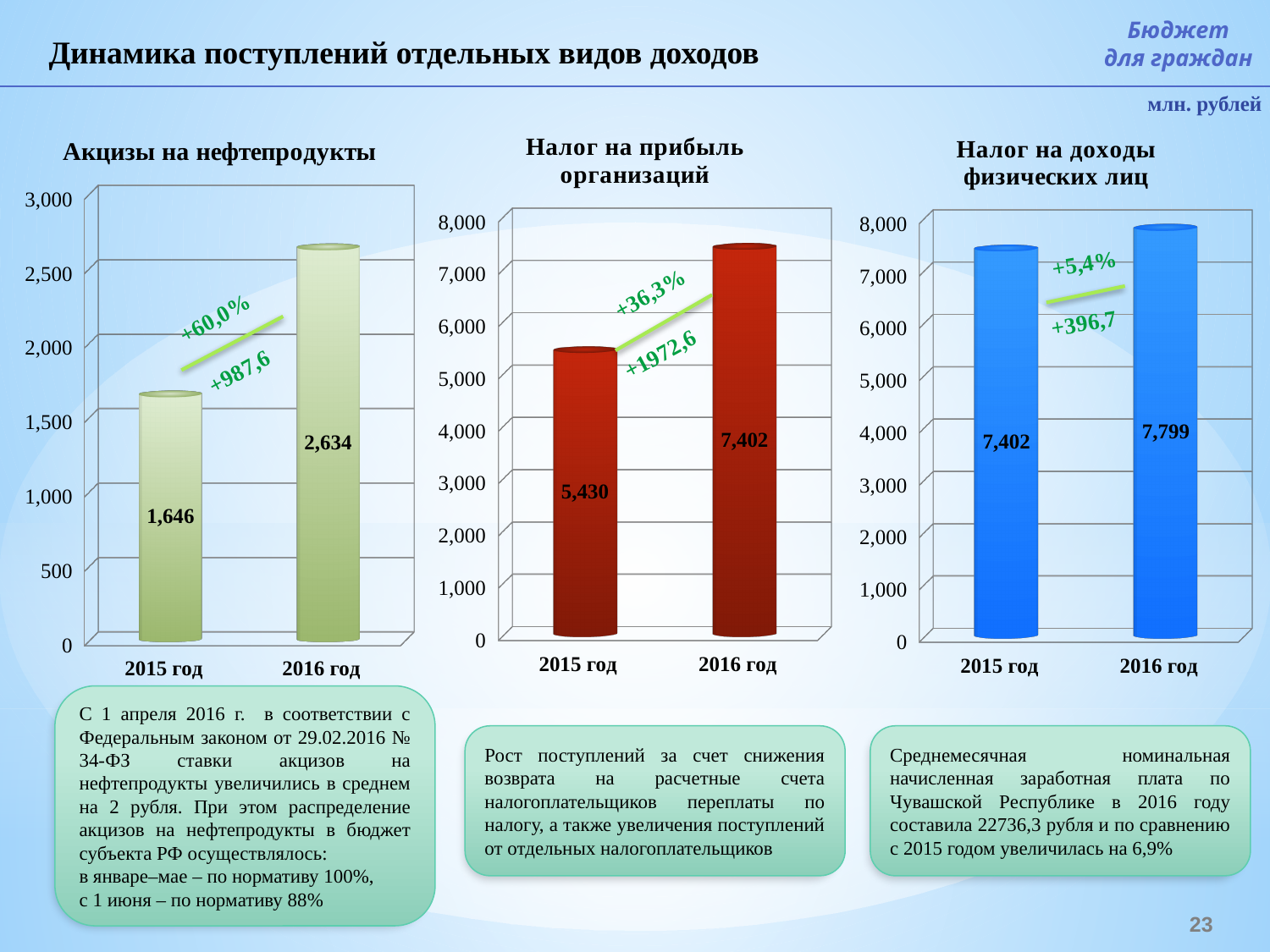
What kind of chart is the chart titled "Налог на доходы физических лиц"? bar chart In the chart titled "Налог на прибыль организаций", what is the value for 2015 год? 5,430 In the chart titled "Акцизы на нефтепродукты", what is the value for 2016 год? 2,634 In the chart titled "Налог на прибыль организаций", which year has the lower value? 2015 год In the chart titled "Налог на доходы физических лиц", what is the value for 2016 год? 7,799 In the chart titled "Налог на прибыль организаций", what percentage growth is annotated between 2015 год and 2016 год? +36,3% In the chart titled "Акцизы на нефтепродукты", what is the value for 2015 год? 1,646 In the chart titled "Налог на доходы физических лиц", which year has the higher value? 2016 год In the chart titled "Налог на прибыль организаций", what is the value for 2016 год? 7,402 In the chart titled "Акцизы на нефтепродукты", is the value for 2016 год greater or less than 2,500? greater In the chart titled "Налог на доходы физических лиц", what percentage growth is annotated between 2015 год and 2016 год? +5,4% How many categories are shown on the x axis of the chart titled "Акцизы на нефтепродукты"? 2